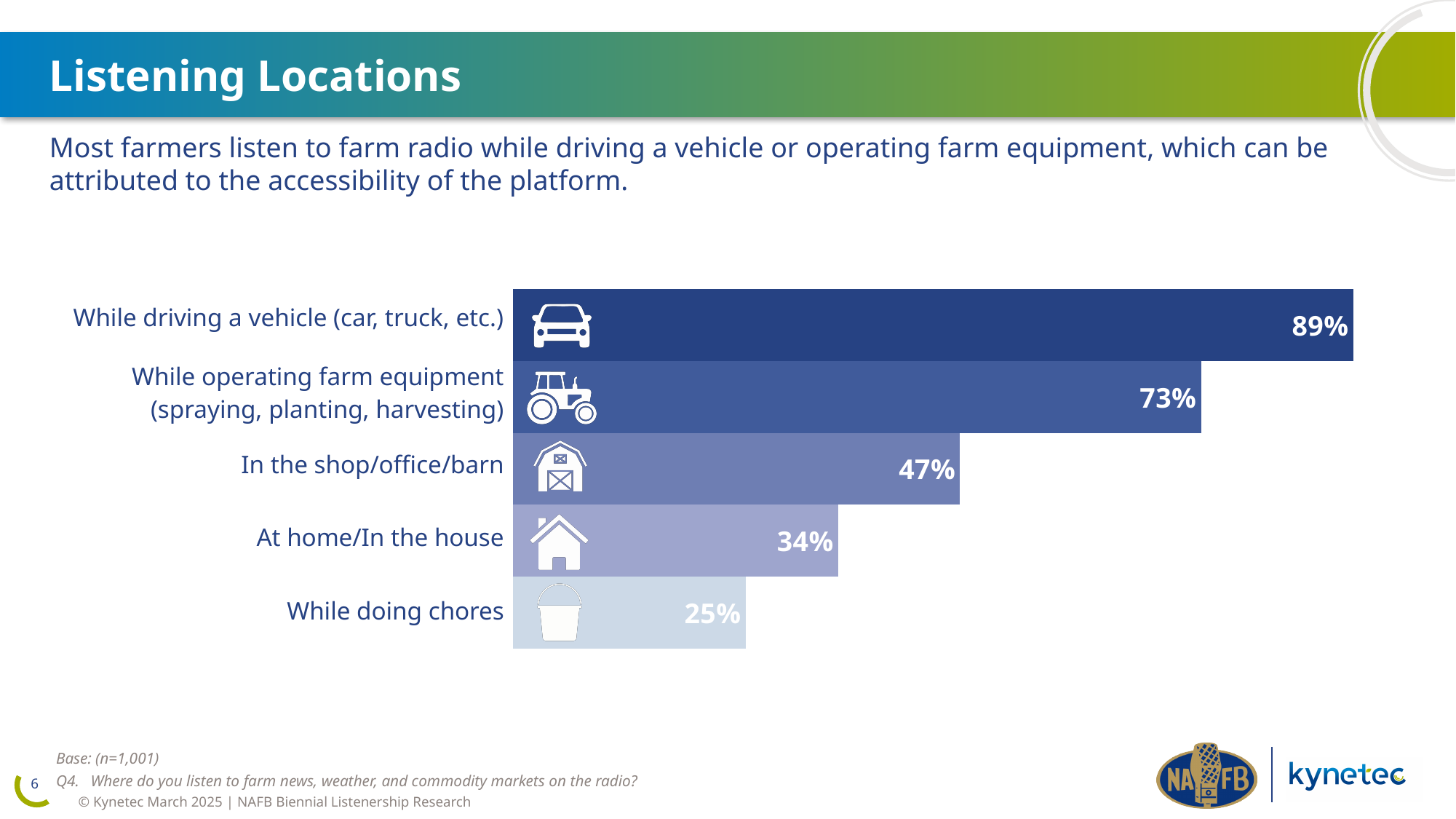
How many listening locations are shown in the chart? 5 Which is larger: the value for 'At home/In the house' or the value for 'While doing chores'? At home/In the house What type of chart is shown on the slide? Bar chart What percentage of farmers listen while doing chores? 25% Which listening location has the highest percentage? While driving a vehicle (car, truck, etc.) Which listening location has the lowest percentage? While doing chores What percentage listen in the shop/office/barn? 47% What is the difference between 'In the shop/office/barn' and 'At home/In the house'? 13% What percentage of farmers listen to farm radio while driving a vehicle (car, truck, etc.)? 89% What is the difference between the percentage for driving a vehicle and the percentage for operating farm equipment? 16% What is the value for 'While operating farm equipment (spraying, planting, harvesting)'? 73% What is the value shown for 'At home/In the house'? 34%